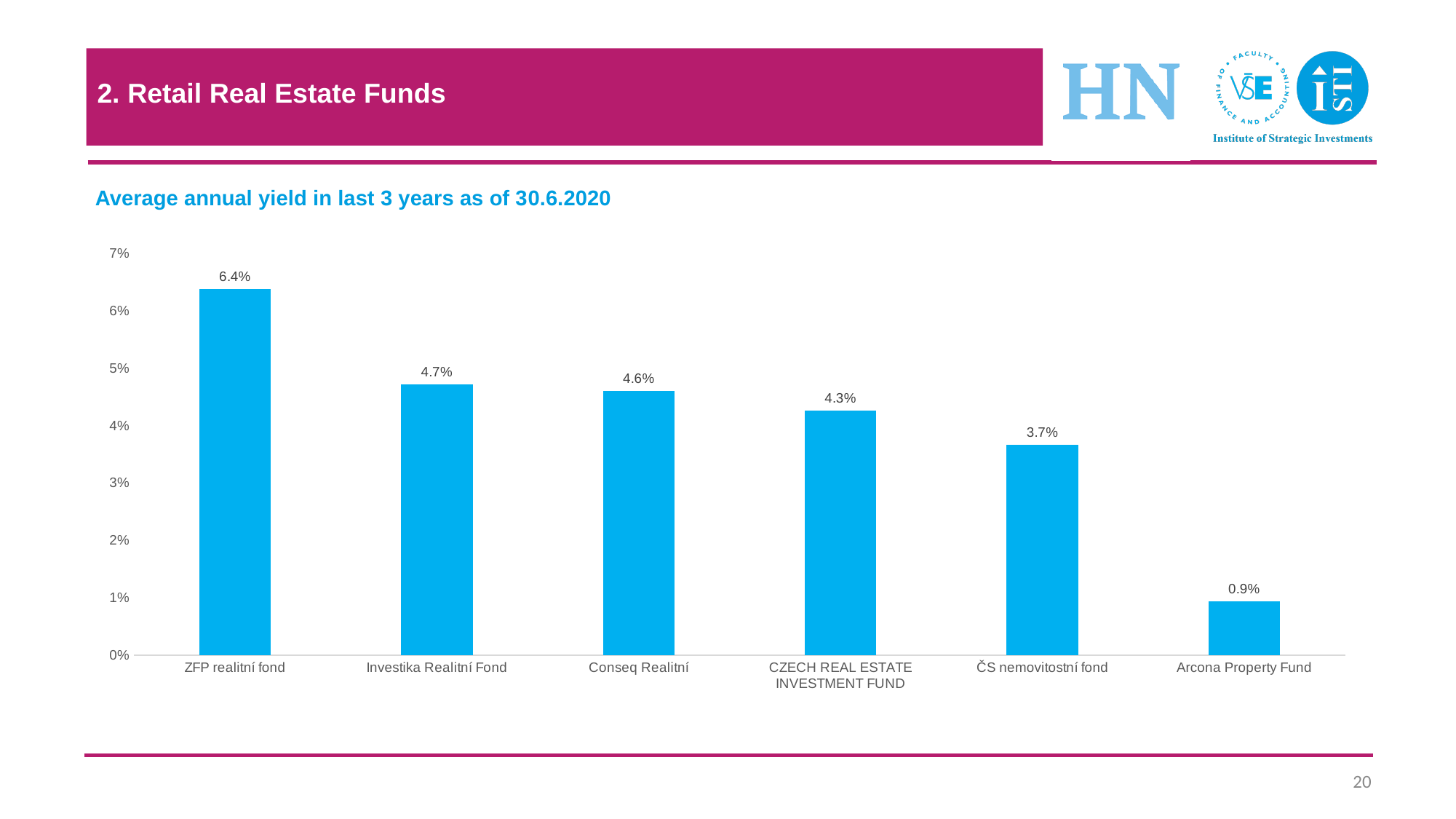
How many funds are shown in the chart? 6 What kind of chart is shown on the slide? Bar chart Which has a higher yield, Conseq Realitní or ČS nemovitostní fond? Conseq Realitní Which fund has the highest average annual yield? ZFP realitní fond What is the average annual yield for CZECH REAL ESTATE INVESTMENT FUND? 4.3% What is the average annual yield for ČS nemovitostní fond? 3.7% What is the average annual yield for Arcona Property Fund? 0.9% What is the difference between the yields of ZFP realitní fond and Investika Realitní Fond? 1.7% What is the title of the chart? Average annual yield in last 3 years as of 30.6.2020 Is the value for Investika Realitní Fond greater or less than 4%? greater What is the average annual yield for ZFP realitní fond? 6.4% Which fund has the lowest average annual yield? Arcona Property Fund